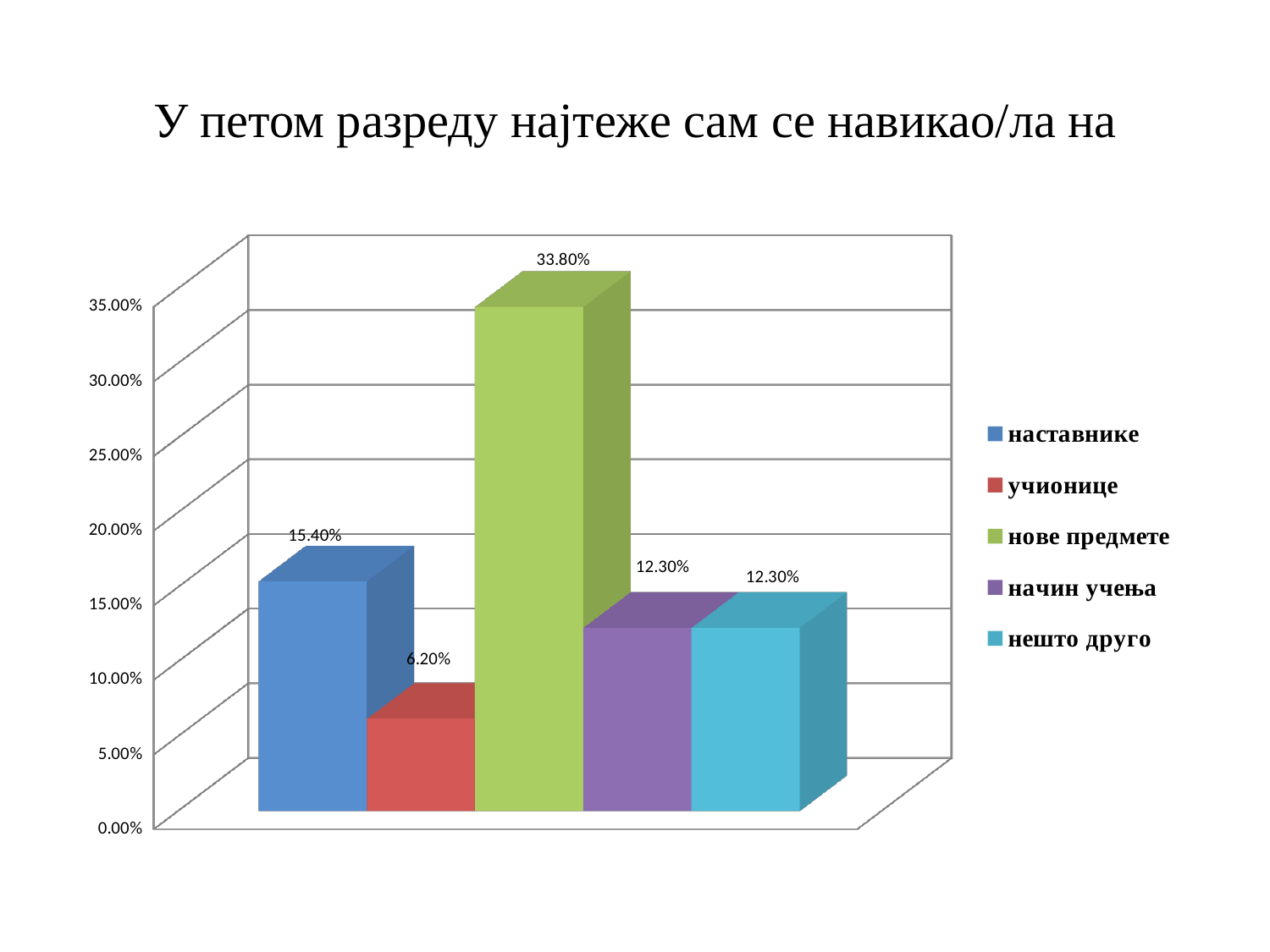
What is the value for нове предмете? 33.80% Which is larger, the value for наставнике or the value for учионице? наставнике What is the value for наставнике? 15.40% What is the difference between the values for нове предмете and наставнике? 18.40% What is the value for начин учења? 12.30% Which category has the lowest value? учионице How many entries does the legend list? 5 Which category has the highest value? нове предмете How many categories are shown in the chart? 5 What kind of chart is shown on the slide? bar chart What is the value for учионице? 6.20% What colour is the bar for нове предмете? green